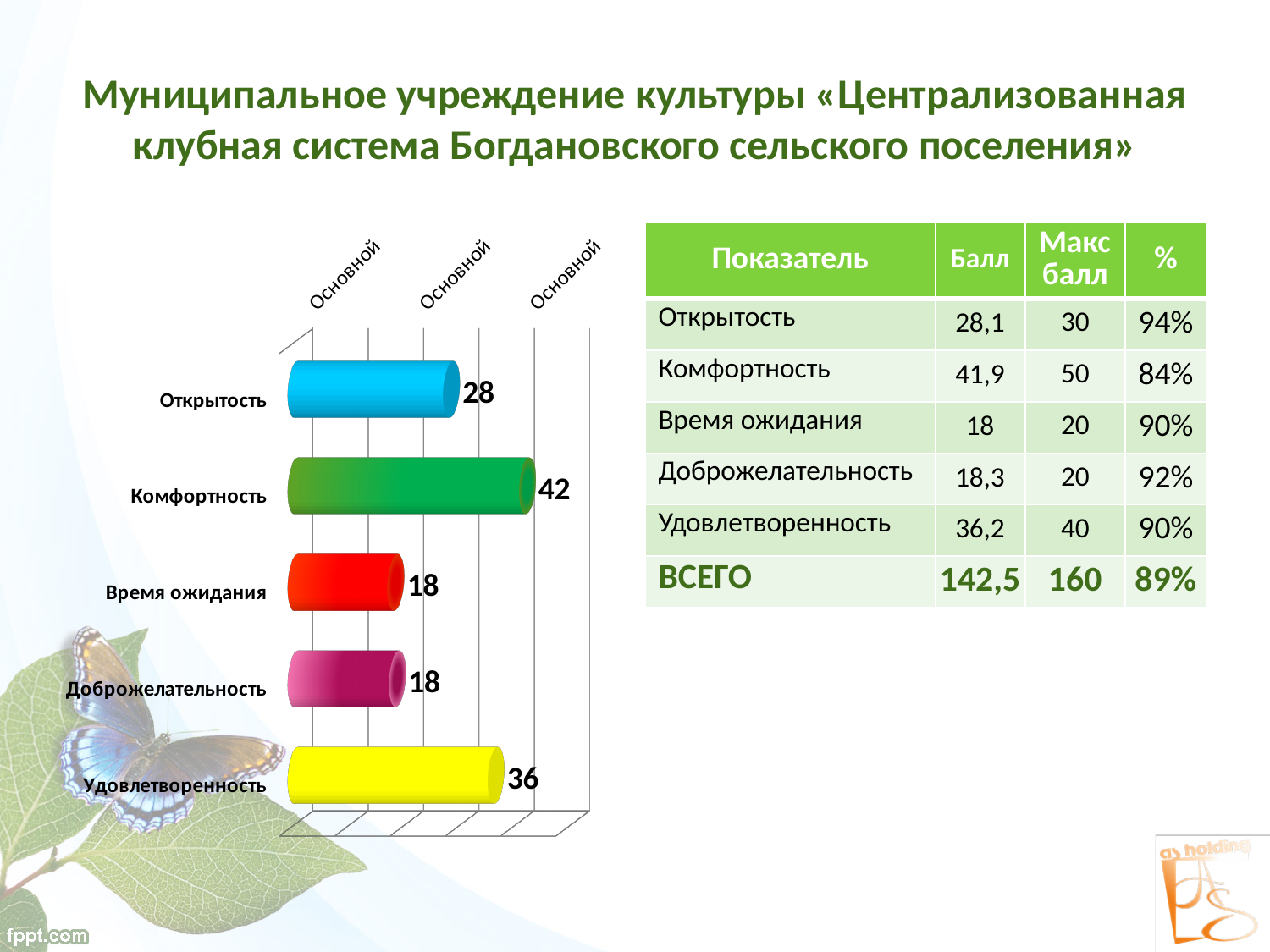
What kind of chart is shown on the slide? Bar chart What value does the chart show for Комфортность? 42 What value does the chart show for Открытость? 28 What value does the chart show for Время ожидания? 18 How many categories are plotted in the chart? 5 Which categories in the chart share the same value of 18? Время ожидания and Доброжелательность What is the difference between the chart values for Комфортность and Удовлетворенность? 6 What value does the chart show for Удовлетворенность? 36 Which is larger in the chart, the value for Удовлетворенность or the value for Открытость? Удовлетворенность What is the difference between the chart values for Открытость and Доброжелательность? 10 What colour is the bar for Удовлетворенность in the chart? Yellow Which category has the highest value in the chart? Комфортность